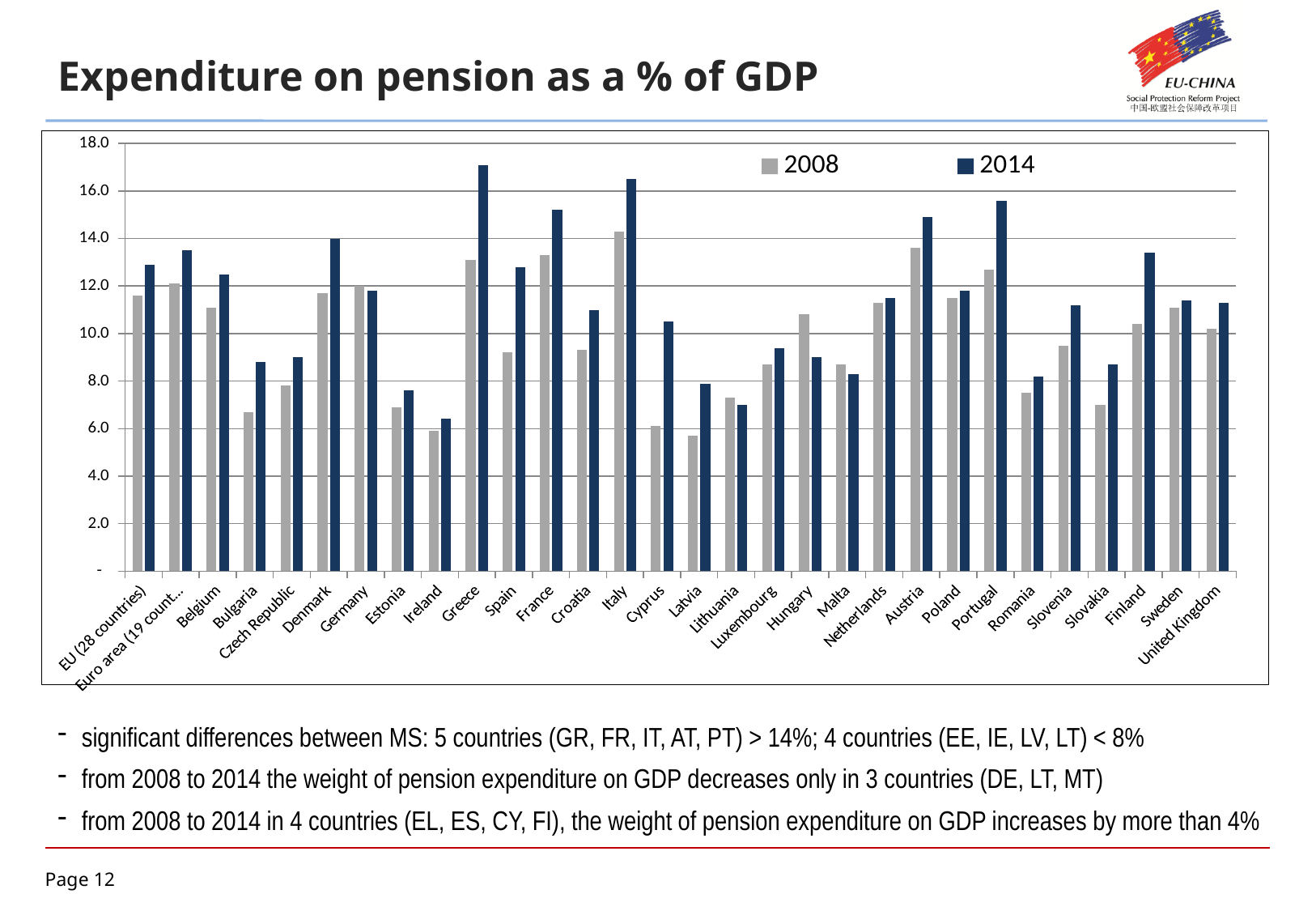
Which colour represents the 2014 series in the legend? dark blue Which country has the highest value for 2014? Greece Is the 2014 value for Portugal greater or less than 14.0? greater What kind of chart is shown on the slide? bar chart Is the 2008 value for Bulgaria greater or less than 8.0? less How many series does the legend list? 2 Is the 2014 value for Greece greater or less than 16.0? greater For Cyprus, which is larger: the 2008 value or the 2014 value? 2014 How many countries or regions are shown along the x axis? 30 Which country has the highest value for 2008? Italy Which country has the lowest value for 2014? Ireland